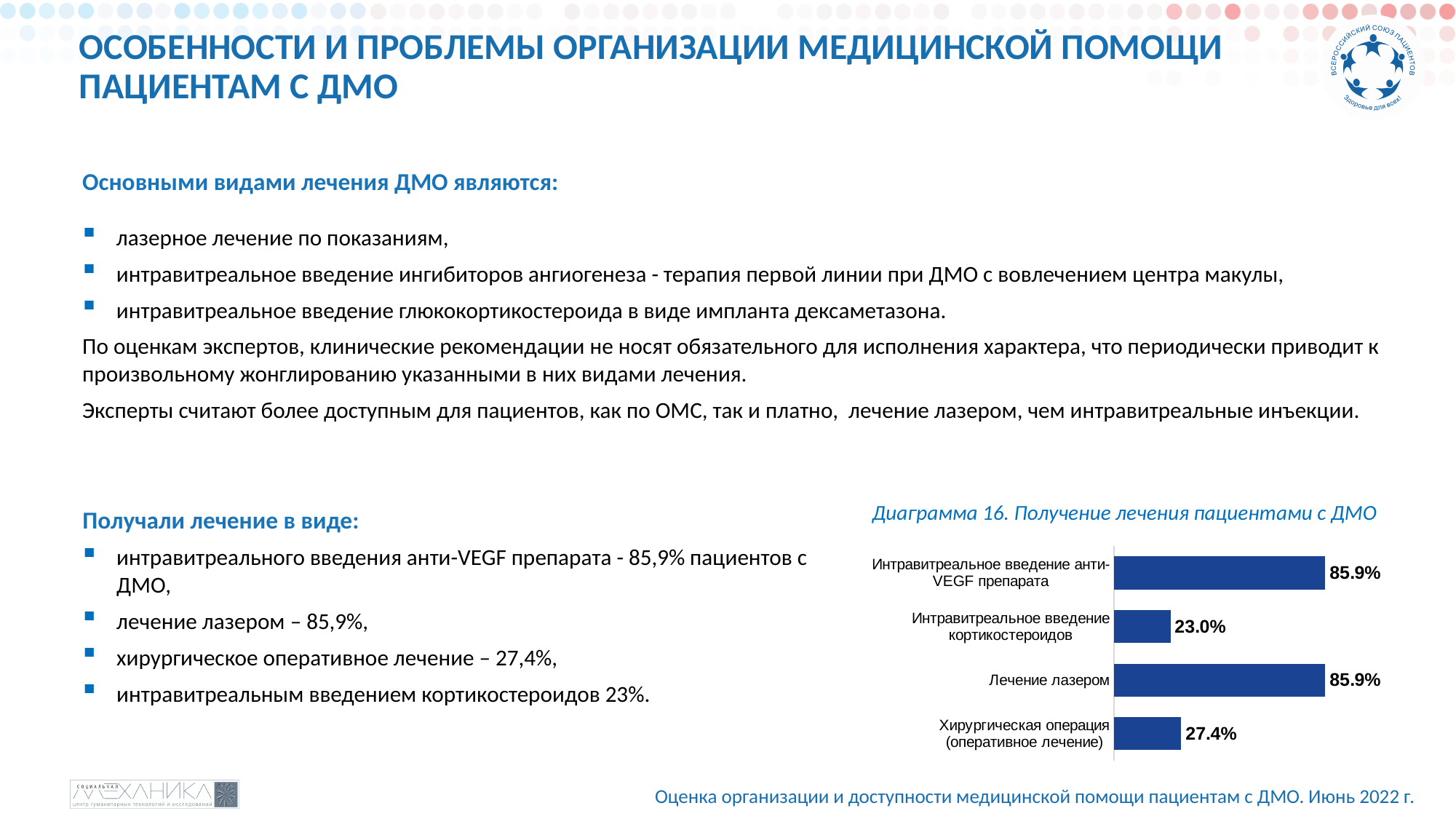
Which is larger in the chart: «Лечение лазером» or «Хирургическая операция (оперативное лечение)»? Лечение лазером What is the difference between the values for «Хирургическая операция (оперативное лечение)» and «Интравитреальное введение кортикостероидов»? 4.4 percentage points What is the title of the chart on the slide? Диаграмма 16. Получение лечения пациентами с ДМО What value is shown for «Хирургическая операция (оперативное лечение)» in the chart? 27.4% What value is shown for «Интравитреальное введение анти-VEGF препарата» in the chart? 85.9% What value is shown for «Интравитреальное введение кортикостероидов» in the chart? 23.0% Which is larger in the chart: «Хирургическая операция (оперативное лечение)» or «Интравитреальное введение кортикостероидов»? Хирургическая операция (оперативное лечение) What is the difference between the values for «Лечение лазером» and «Хирургическая операция (оперативное лечение)»? 58.5 percentage points How many categories are shown in the chart? 4 What type of chart is shown on the slide? Bar chart Which category has the lowest value in the chart? Интравитреальное введение кортикостероидов What value is shown for «Лечение лазером» in the chart? 85.9%